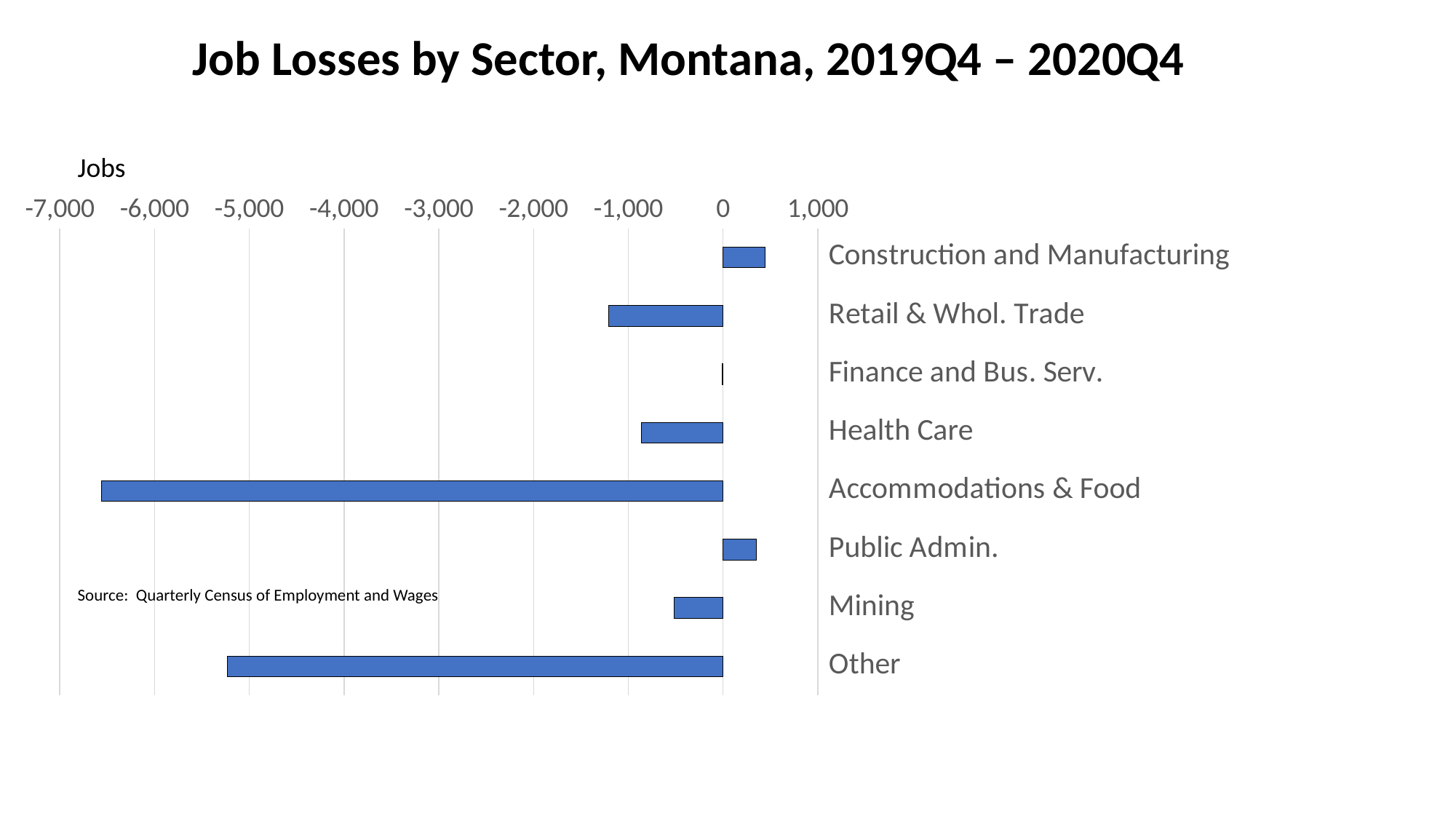
What label is shown on the value axis of the chart? Jobs Which sector shows a larger job loss, Accommodations & Food or Other? Accommodations & Food Which sector shows a larger job loss, Retail & Whol. Trade or Health Care? Retail & Whol. Trade Is the value for Retail & Whol. Trade greater or less than -1,000? less What kind of chart is shown on the slide? bar chart Which sector has the lowest (most negative) value in the chart? Accommodations & Food What is the title of the chart? Job Losses by Sector, Montana, 2019Q4 – 2020Q4 Is the value for Health Care greater or less than -1,000? greater How many sectors are plotted in the chart? 8 Is the value for Other greater or less than -5,000? less